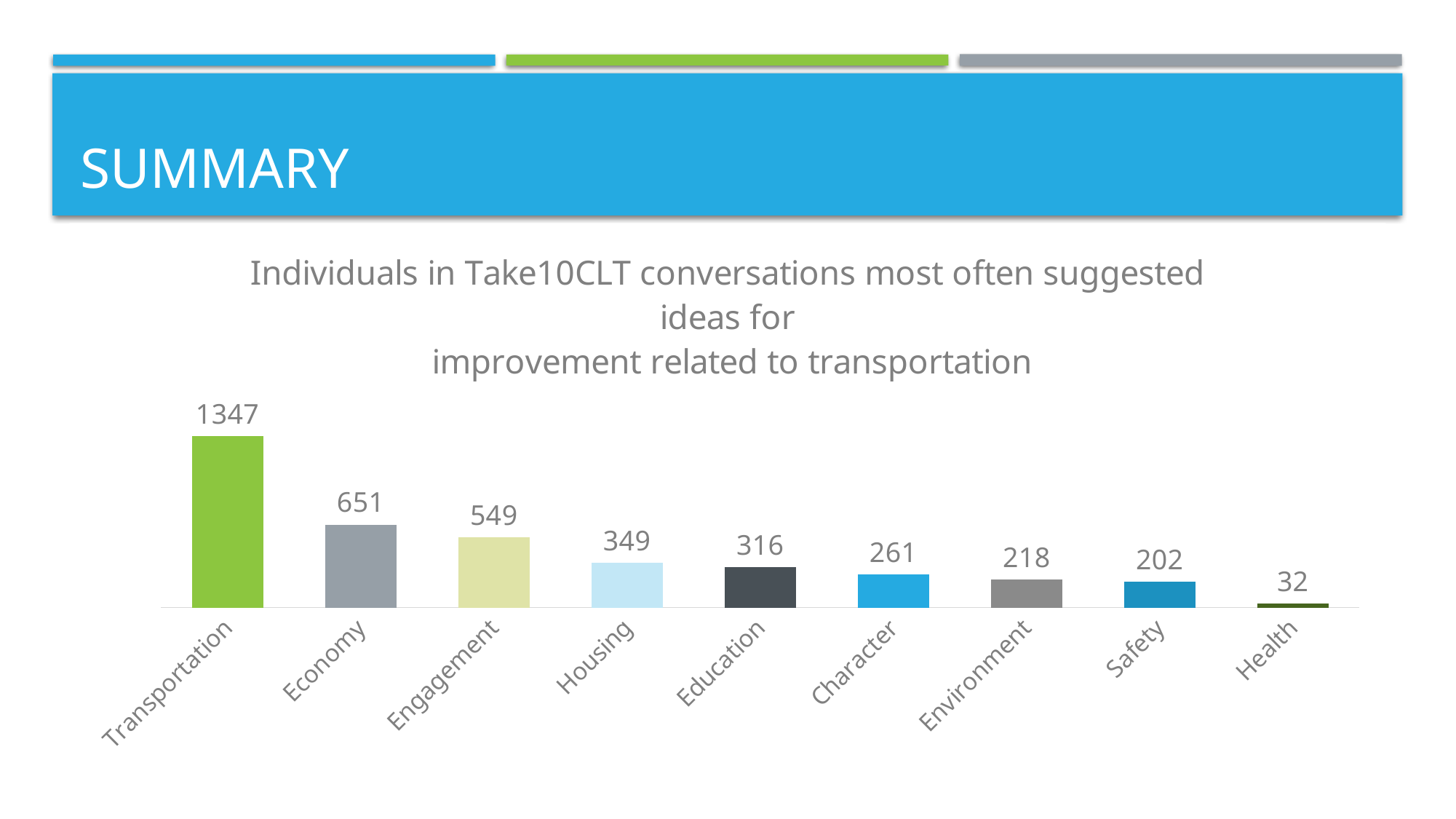
What is the value for Housing? 349 Which category has the lowest value? Health Which category has the highest value? Transportation Which is larger, the value for Education or the value for Character? Education What kind of chart is shown on the slide? Bar chart How many categories are shown in the chart? 9 Which is larger, the value for Safety or the value for Environment? Environment What is the difference between the values for Transportation and Economy? 696 What is the value for Environment? 218 What is the difference between the values for Economy and Engagement? 102 What is the value for Transportation? 1347 Do the values rise or fall from left to right along the x axis? Fall